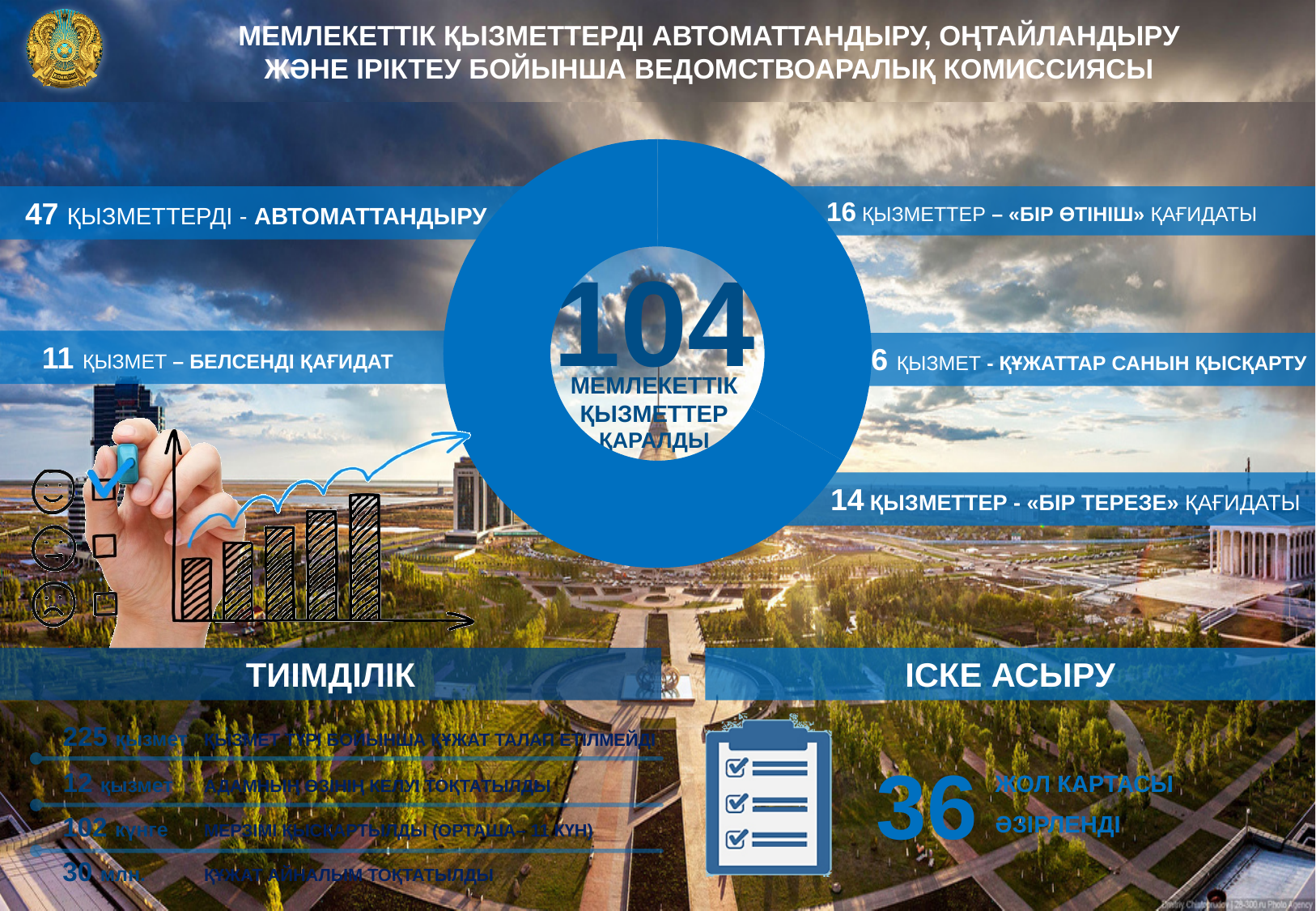
How many services are labelled for the «БІР ӨТІНІШ» ҚАҒИДАТЫ around the donut chart? 16 Which has more services: the «БІР ТЕРЕЗЕ» ҚАҒИДАТЫ or БЕЛСЕНДІ ҚАҒИДАТ? «БІР ТЕРЕЗЕ» ҚАҒИДАТЫ What number is printed in the centre of the donut chart? 104 Which category labelled around the donut chart has the highest number of services? АВТОМАТТАНДЫРУ How many services are labelled for the «БІР ТЕРЕЗЕ» ҚАҒИДАТЫ around the donut chart? 14 How many services are labelled for ҚҰЖАТТАР САНЫН ҚЫСҚАРТУ around the donut chart? 6 What text appears under the number 104 in the centre of the donut chart? МЕМЛЕКЕТТІК ҚЫЗМЕТТЕР ҚАРАЛДЫ How many services are labelled for БЕЛСЕНДІ ҚАҒИДАТ around the donut chart? 11 What is the difference between the number of services for АВТОМАТТАНДЫРУ and for the «БІР ӨТІНІШ» ҚАҒИДАТЫ? 31 What kind of chart is shown in the centre of the slide? pie chart (donut) How many services are labelled for АВТОМАТТАНДЫРУ around the donut chart? 47 Which category labelled around the donut chart has the lowest number of services? ҚҰЖАТТАР САНЫН ҚЫСҚАРТУ